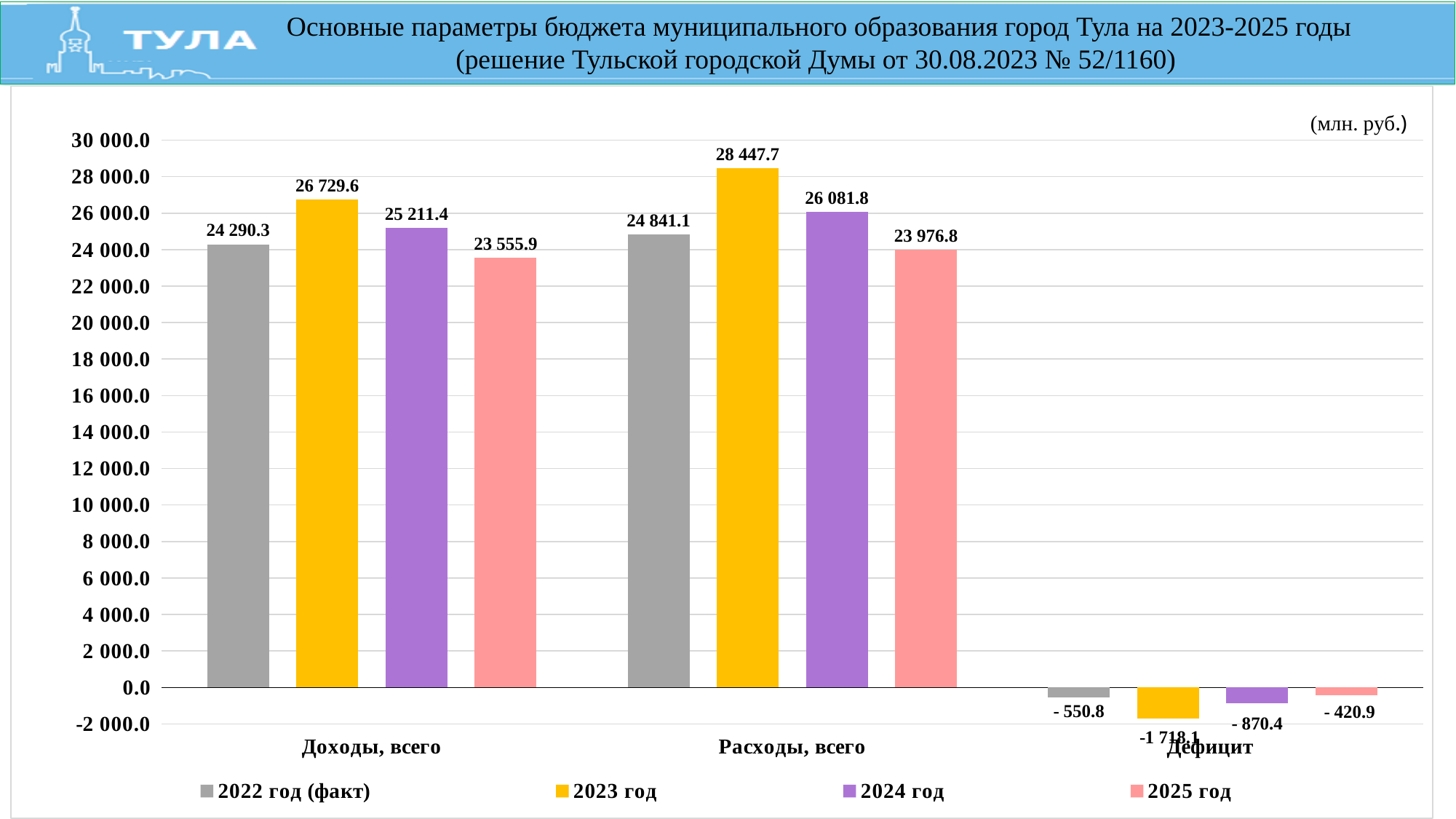
What unit is indicated in the top right corner of the chart? (млн. руб.) Which year has the lowest value in the Доходы, всего category? 2025 год What is the difference between the 2023 год and 2022 год (факт) values in the Доходы, всего category? 2 439.3 What type of chart is shown on the slide? bar chart Is the 2022 год (факт) value for Расходы, всего greater or less than 24 000.0? greater How many series does the legend list? 4 Which is larger: the 2024 год value for Доходы, всего or the 2024 год value for Расходы, всего? Расходы, всего Which year has the highest value in the Расходы, всего category? 2023 год What is the value for 2025 год in the Расходы, всего category? 23 976.8 What is the value for 2023 год in the Доходы, всего category? 26 729.6 How many categories are shown on the x axis? 3 What is the value for 2022 год (факт) in the Дефицит category? - 550.8